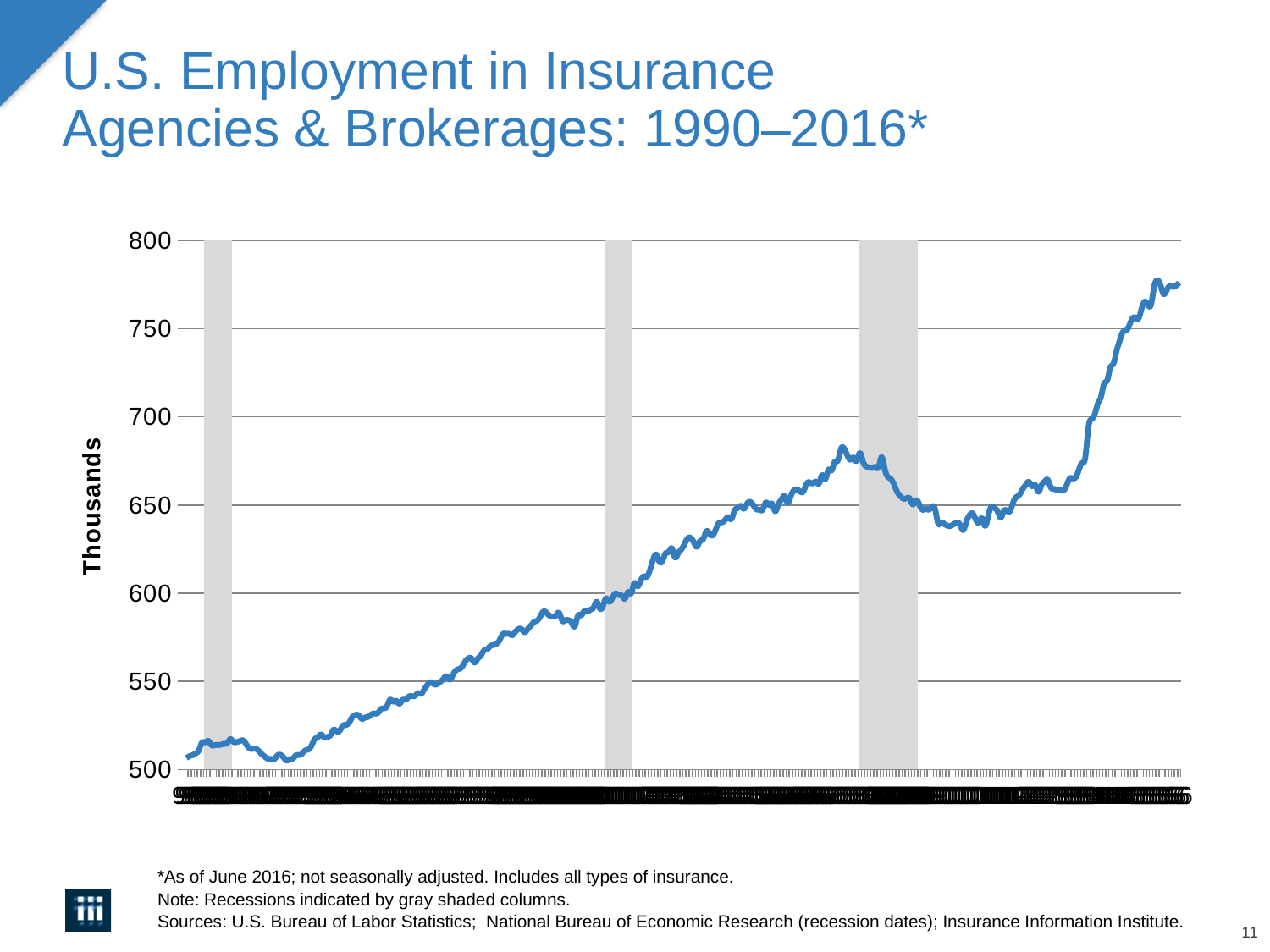
What kind of chart is shown on the slide? line chart How many gray shaded recession columns are shown on the chart? 3 Is the value at the left end of the line (start of 1990) greater or less than 550? less Is the peak reached just before the third gray shaded column greater or less than 650? greater Is the lowest point on the line greater or less than 550? less Overall, do the values rise or fall from the left end of the chart to the right end? rise What is the label on the vertical axis of the chart? Thousands Is the value at the right end of the line larger or smaller than the value at the left end? larger What is the title of the chart on the slide? U.S. Employment in Insurance Agencies & Brokerages: 1990–2016*